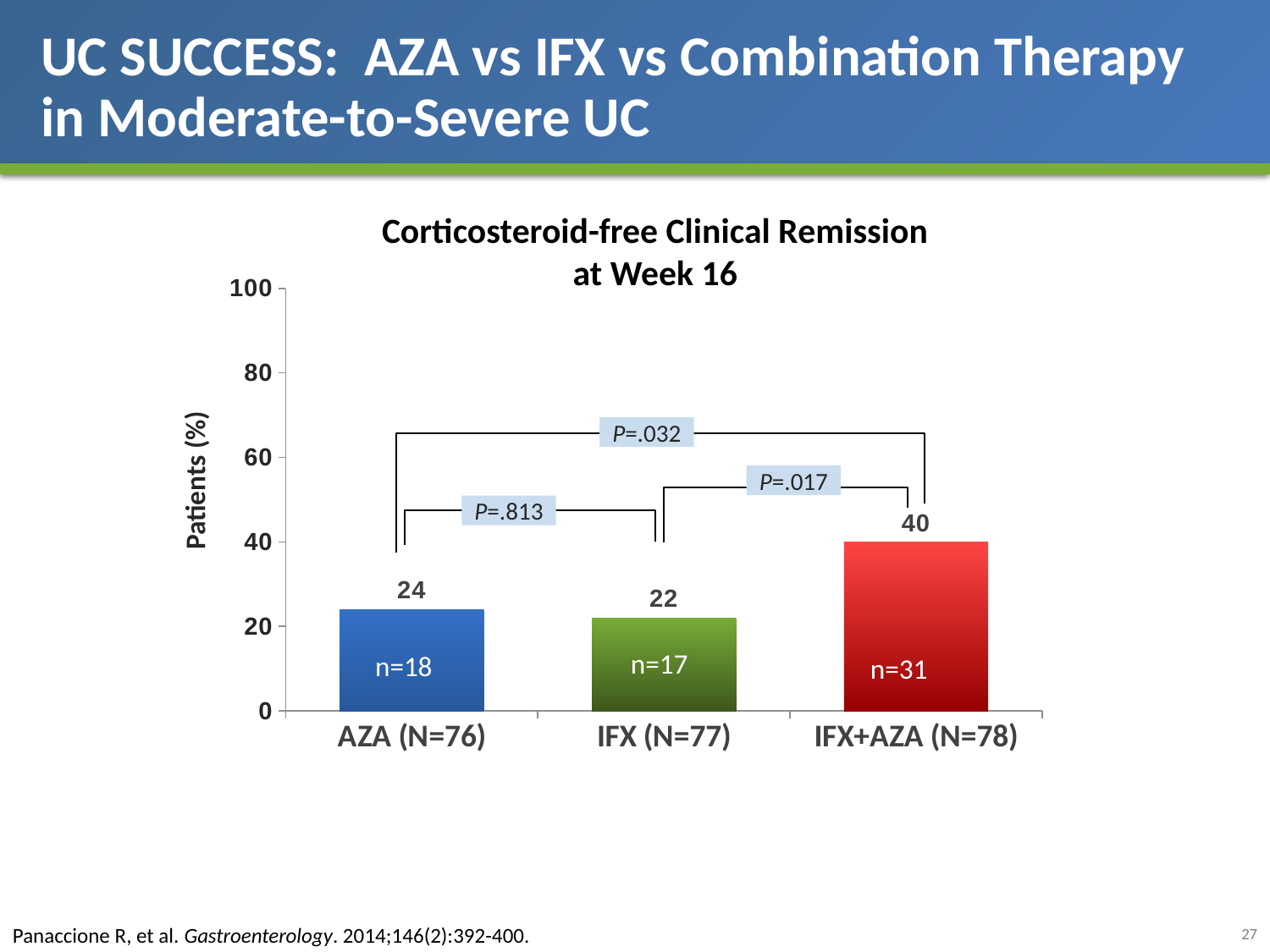
What is the title of the chart? Corticosteroid-free Clinical Remission at Week 16 What is the value for IFX (N=77)? 22 How many categories are shown on the x axis? 3 What is the difference between the values for IFX+AZA (N=78) and IFX (N=77)? 18 Which category has the lowest value? IFX (N=77) What is the value for IFX+AZA (N=78)? 40 Is the value for IFX+AZA (N=78) greater or less than 60? less Which is larger, the value for IFX+AZA (N=78) or the value for IFX (N=77)? IFX+AZA (N=78) What is the difference between the values for IFX+AZA (N=78) and AZA (N=76)? 16 What kind of chart is shown? bar chart Which category has the highest value? IFX+AZA (N=78) What is the value for AZA (N=76)? 24